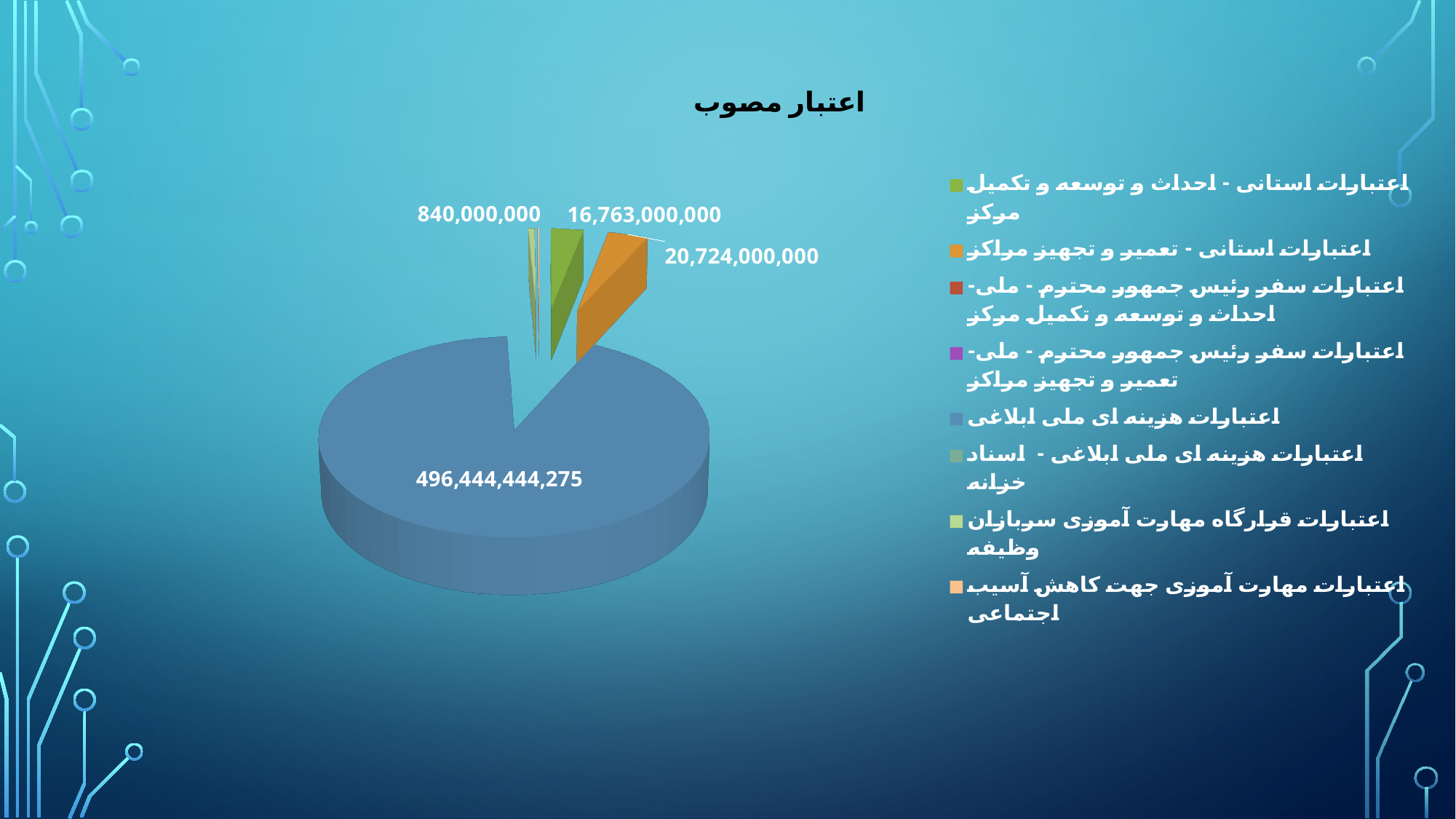
What is the value of the slice for اعتبارات استانی - احداث و توسعه و تکمیل مرکز? 16,763,000,000 Which category has the largest slice of the pie? اعتبارات هزینه ای ملی ابلاغی How many data labels are printed on the pie chart? 4 What is the difference between the values for اعتبارات هزینه ای ملی ابلاغی and اعتبارات استانی - تعمیر و تجهیز مراکز? 475,720,444,275 What kind of chart is shown on the slide? pie chart What is the value of the slice for اعتبارات هزینه ای ملی ابلاغی? 496,444,444,275 What is the smallest value printed as a data label on the chart? 840,000,000 What is the value of the slice for اعتبارات استانی - تعمیر و تجهیز مراکز? 20,724,000,000 What is the title of the chart? اعتبار مصوب How many entries does the chart legend list? 8 What is the difference between the values for اعتبارات استانی - تعمیر و تجهیز مراکز and اعتبارات استانی - احداث و توسعه و تکمیل مرکز? 3,961,000,000 Which is larger: the slice for اعتبارات استانی - تعمیر و تجهیز مراکز or the slice for اعتبارات استانی - احداث و توسعه و تکمیل مرکز? اعتبارات استانی - تعمیر و تجهیز مراکز